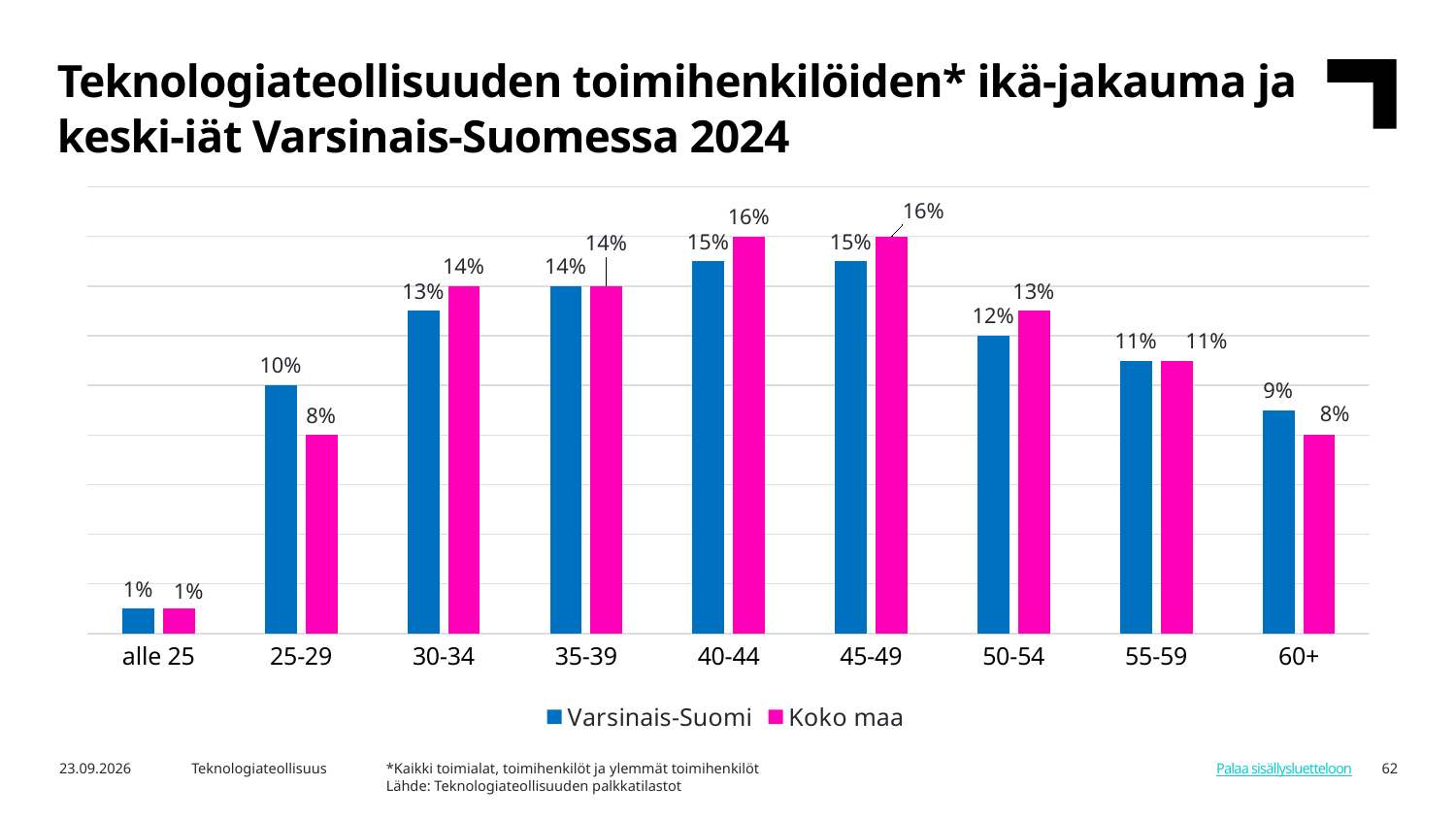
What is the difference between the Koko maa and Varsinais-Suomi values in the 25-29 age group? 2% What kind of chart is shown on the slide? Bar chart Which colour represents the Koko maa series? Pink In the 60+ age group, which series has the larger value, Varsinais-Suomi or Koko maa? Varsinais-Suomi What is the difference between the Varsinais-Suomi values for 45-49 and 50-54? 3% What is the value for Koko maa in the 50-54 age group? 13% Which age group has the lowest value for Koko maa? alle 25 What is the value for Varsinais-Suomi in the 25-29 age group? 10% How many age groups are shown on the x axis? 9 In the 30-34 age group, which series has the larger value, Varsinais-Suomi or Koko maa? Koko maa How many series does the legend list? 2 What is the value for Varsinais-Suomi in the 60+ age group? 9%